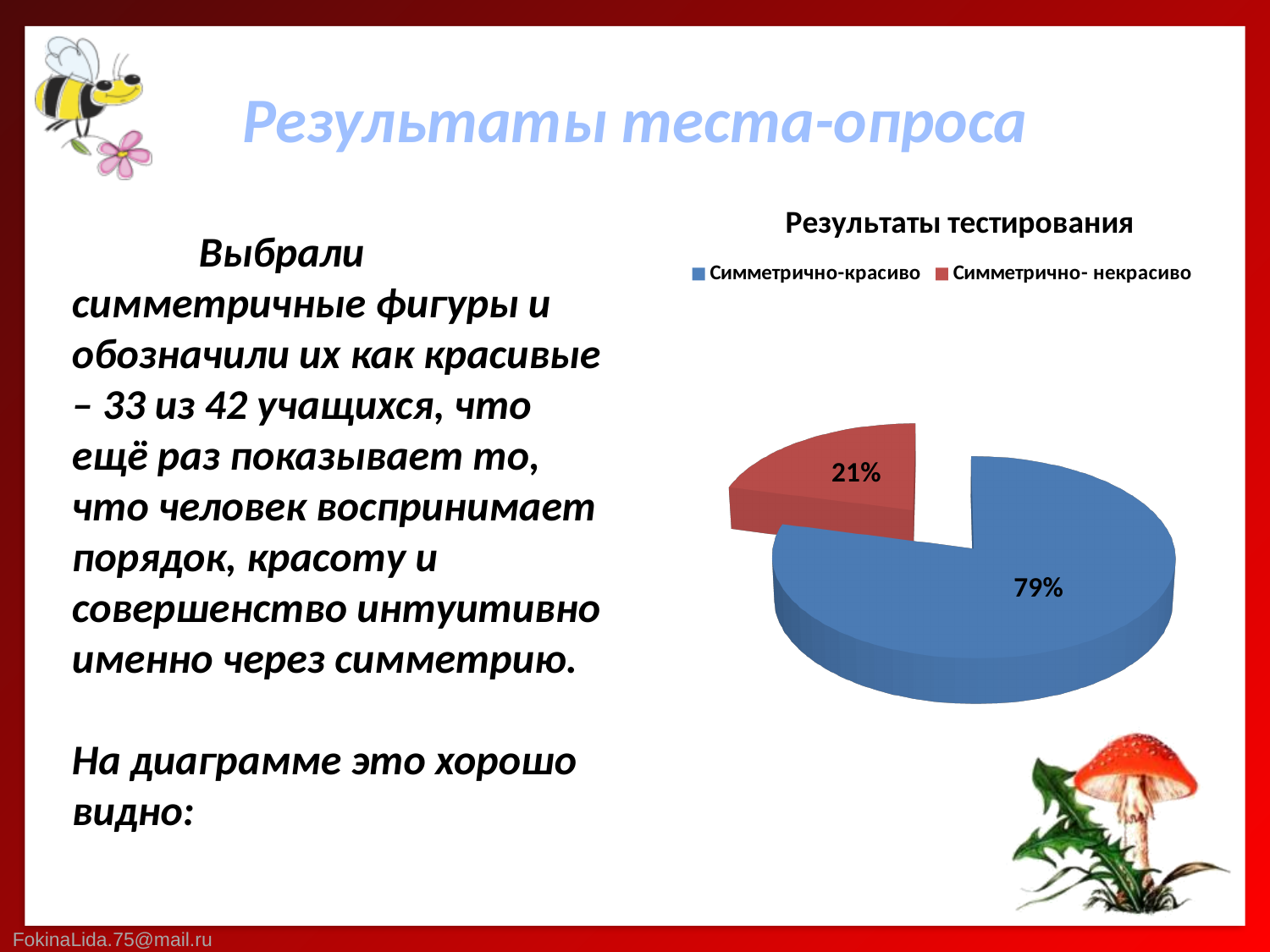
What is the title of the chart? Результаты тестирования What colour is the "Симметрично- некрасиво" slice? red Which category has the largest slice of the pie? Симметрично-красиво What is the difference in percentage points between the "Симметрично-красиво" and "Симметрично- некрасиво" slices? 58% What share of the pie does "Симметрично-красиво" take? 79% Which category has the smallest slice of the pie? Симметрично- некрасиво What type of chart is shown on the slide? pie chart How many slices does the pie chart have? 2 Which is larger: the "Симметрично-красиво" slice or the "Симметрично- некрасиво" slice? Симметрично-красиво What share of the pie does "Симметрично- некрасиво" take? 21% How many entries does the legend list? 2